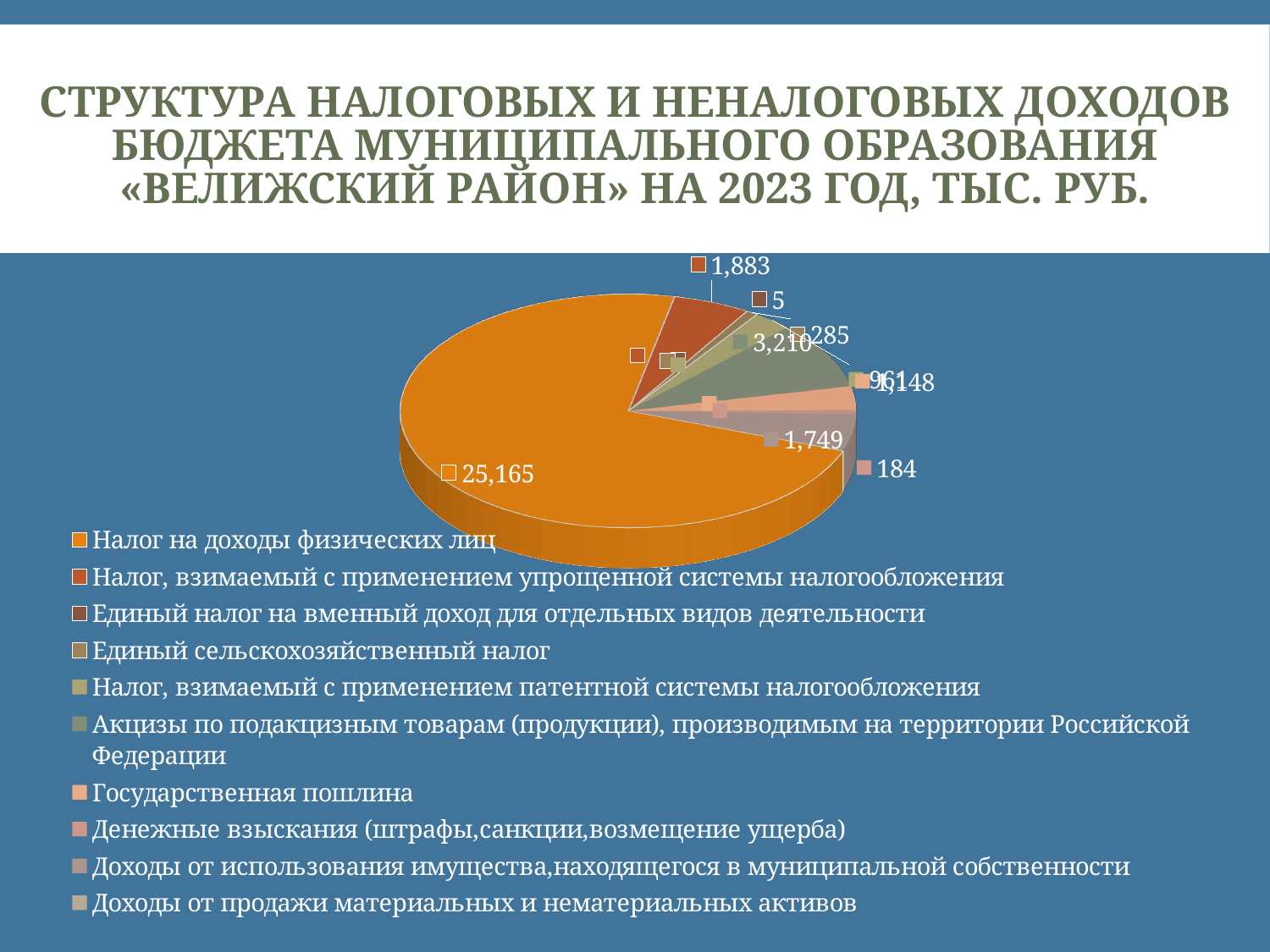
What is the difference between the slices labelled 3,210 and 1,749? 1,461 Which category has the largest slice in the pie chart? Налог на доходы физических лиц What kind of chart is shown on the slide? pie chart What is the difference between the slice labelled 25,165 and the slice labelled 1,883? 23,282 What year does the chart title refer to? 2023 What is the smallest value labelled on the pie chart? 5 What is the value shown for 'Налог, взимаемый с применением упрощенной системы налогообложения'? 1,883 What is the value of the largest slice in the pie chart? 25,165 How many categories does the legend list? 10 Which is larger: the slice labelled 1,883 or the slice labelled 1,749? 1,883 In what units are the values in the chart given, according to the title? тыс. руб. Which category has the smallest labelled value on the pie chart? Единый налог на вменный доход для отдельных видов деятельности